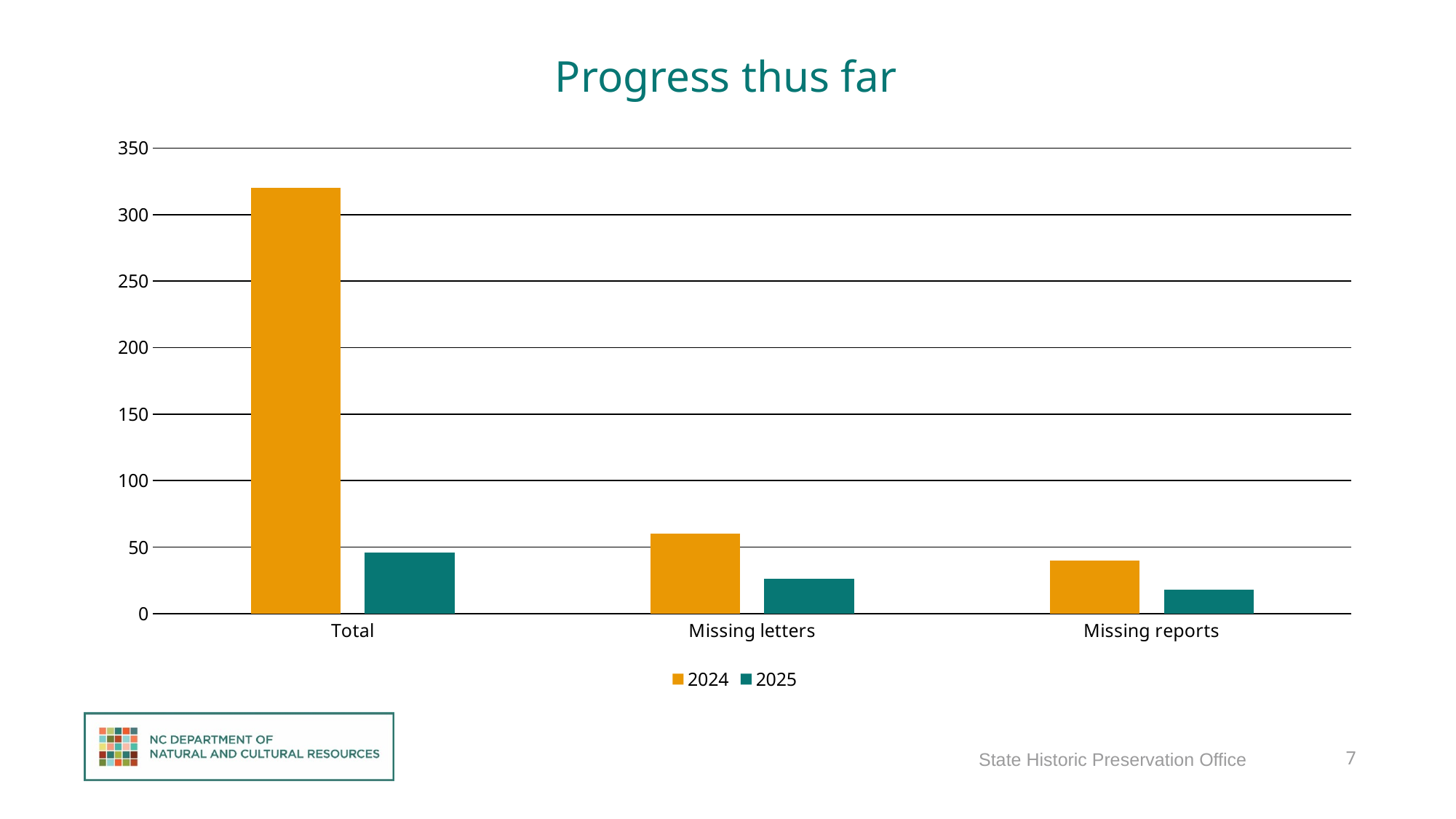
Is the 2025 value for Total greater or less than 50? less Which category has the lowest value for 2025? Missing reports How many series does the legend list? 2 Is the 2024 value for Missing letters greater or less than 50? greater What is the title of the chart? Progress thus far Which is larger for Missing reports, the 2024 value or the 2025 value? 2024 How many categories are shown on the x axis? 3 Is the 2024 value for Total greater or less than 300? greater What kind of chart is shown on the slide? bar chart Do the 2024 values rise or fall from Total to Missing reports along the x axis? fall Which category has the highest value for 2024? Total Which series is shown in orange? 2024